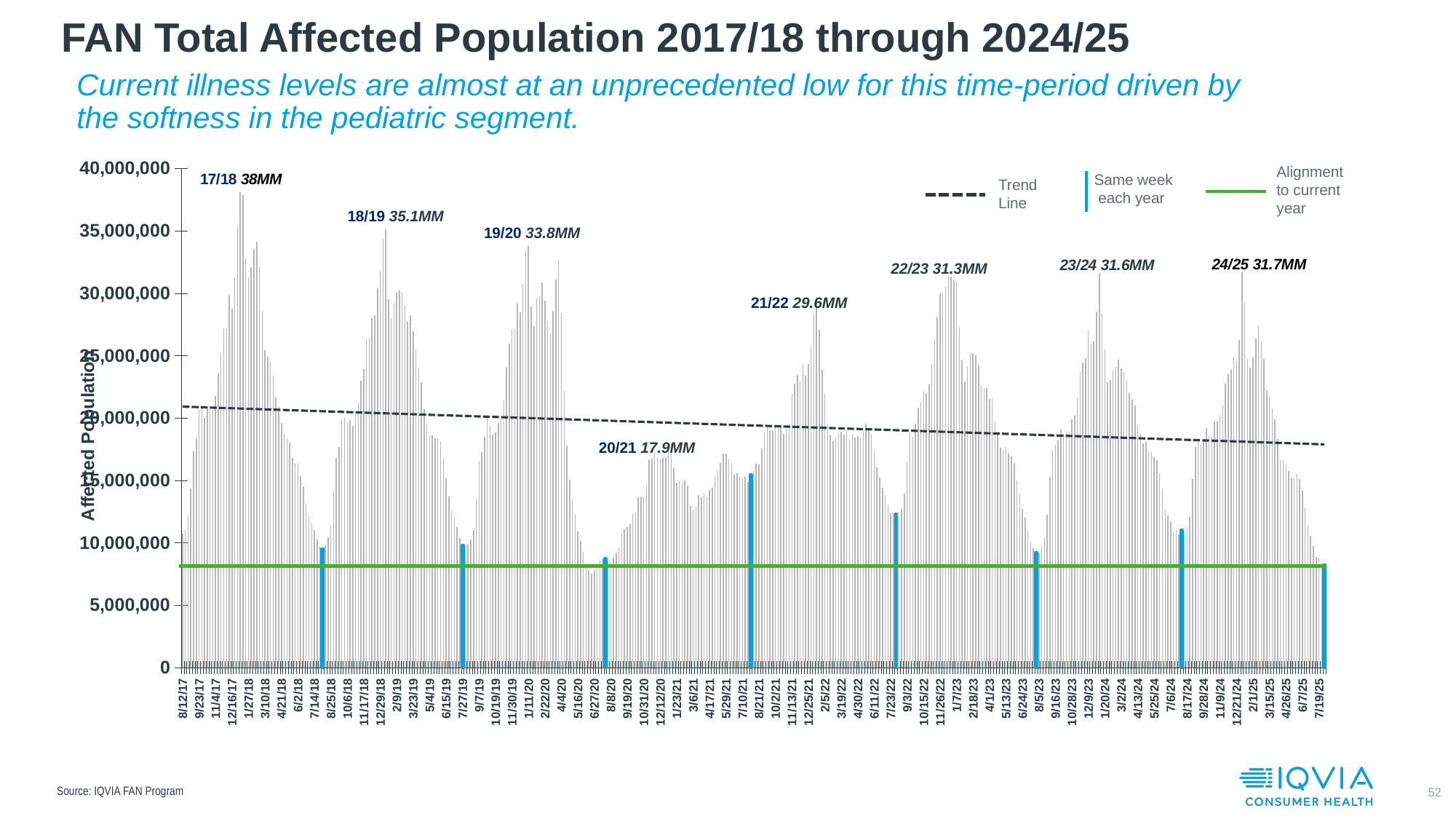
Is the green 'Alignment to current year' line greater or less than 10,000,000? less What is the difference between the annotated peaks for the 17/18 and 18/19 seasons? 2.9MM Does the dashed trend line rise or fall from left to right across the chart? fall How many entries does the chart legend list? 3 What is the peak affected population annotated for the 17/18 season? 38MM What is the peak affected population annotated for the 20/21 season? 17.9MM What is the peak affected population annotated for the 24/25 season? 31.7MM What type of chart is used to show the weekly affected population? bar chart Which season has the lowest annotated peak affected population? 20/21 Which season has the highest annotated peak affected population? 17/18 Which season has a larger annotated peak, 19/20 or 21/22? 19/20 What is the difference between the annotated peaks for the 24/25 and 20/21 seasons? 13.8MM